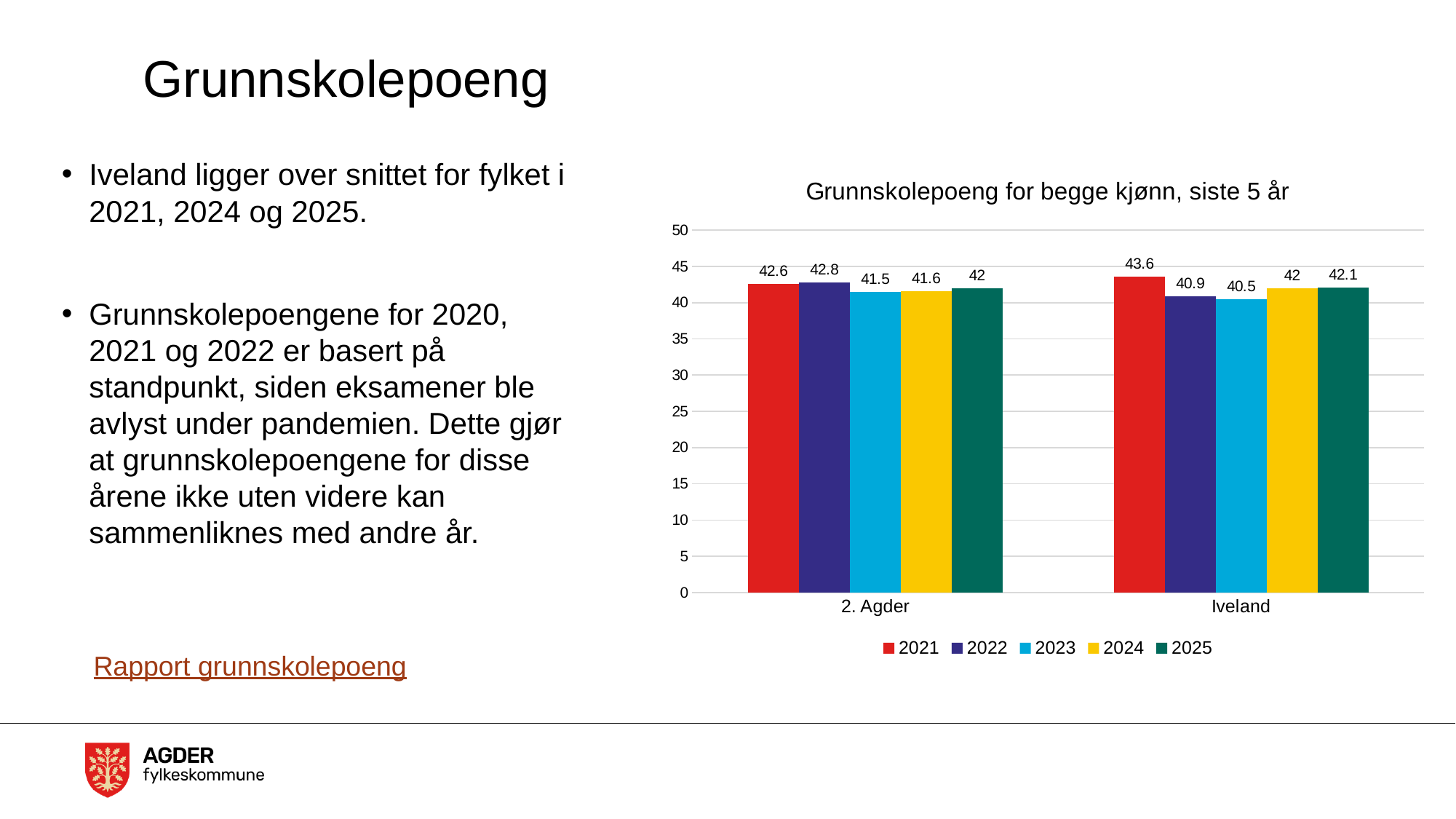
What is the difference between the 2021 values for Iveland and 2. Agder? 1 Which is larger, the 2022 value for 2. Agder or the 2022 value for Iveland? 2. Agder Which year has the highest value for Iveland? 2021 What is the value for 2. Agder in 2021? 42.6 How many categories are shown on the x axis? 2 What kind of chart is shown? bar chart How many series does the legend list? 5 What is the value for Iveland in 2025? 42.1 What is the value for Iveland in 2023? 40.5 What is the title of the chart? Grunnskolepoeng for begge kjønn, siste 5 år Is the value for Iveland in 2021 greater or less than 40? greater Which year has the lowest value for 2. Agder? 2023